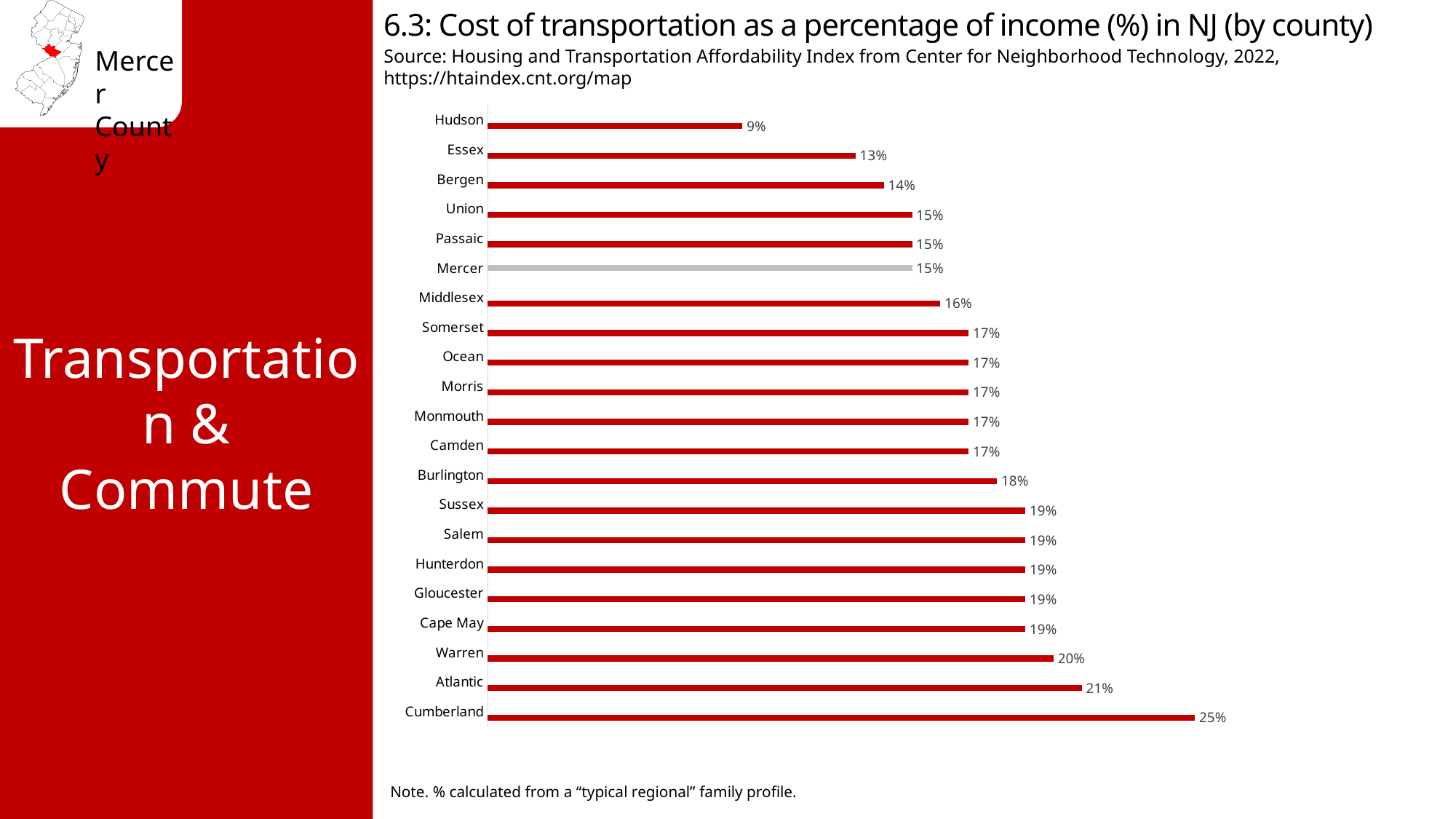
What is the cost of transportation as a percentage of income for Atlantic County? 21% Which county has the lowest cost of transportation as a percentage of income? Hudson Which county has the highest cost of transportation as a percentage of income? Cumberland What is the difference in percentage points between Warren and Mercer? 5 What is the cost of transportation as a percentage of income for Mercer County? 15% What type of chart is shown on the slide? Bar chart What is the cost of transportation as a percentage of income for Hudson County? 9% What is the difference in percentage points between Cumberland and Hudson? 16 Which county has a higher cost of transportation as a percentage of income, Essex or Middlesex? Middlesex What is the cost of transportation as a percentage of income for Burlington County? 18% Which county's bar is shown in a different colour (grey) from the others? Mercer How many counties are shown in the chart? 21